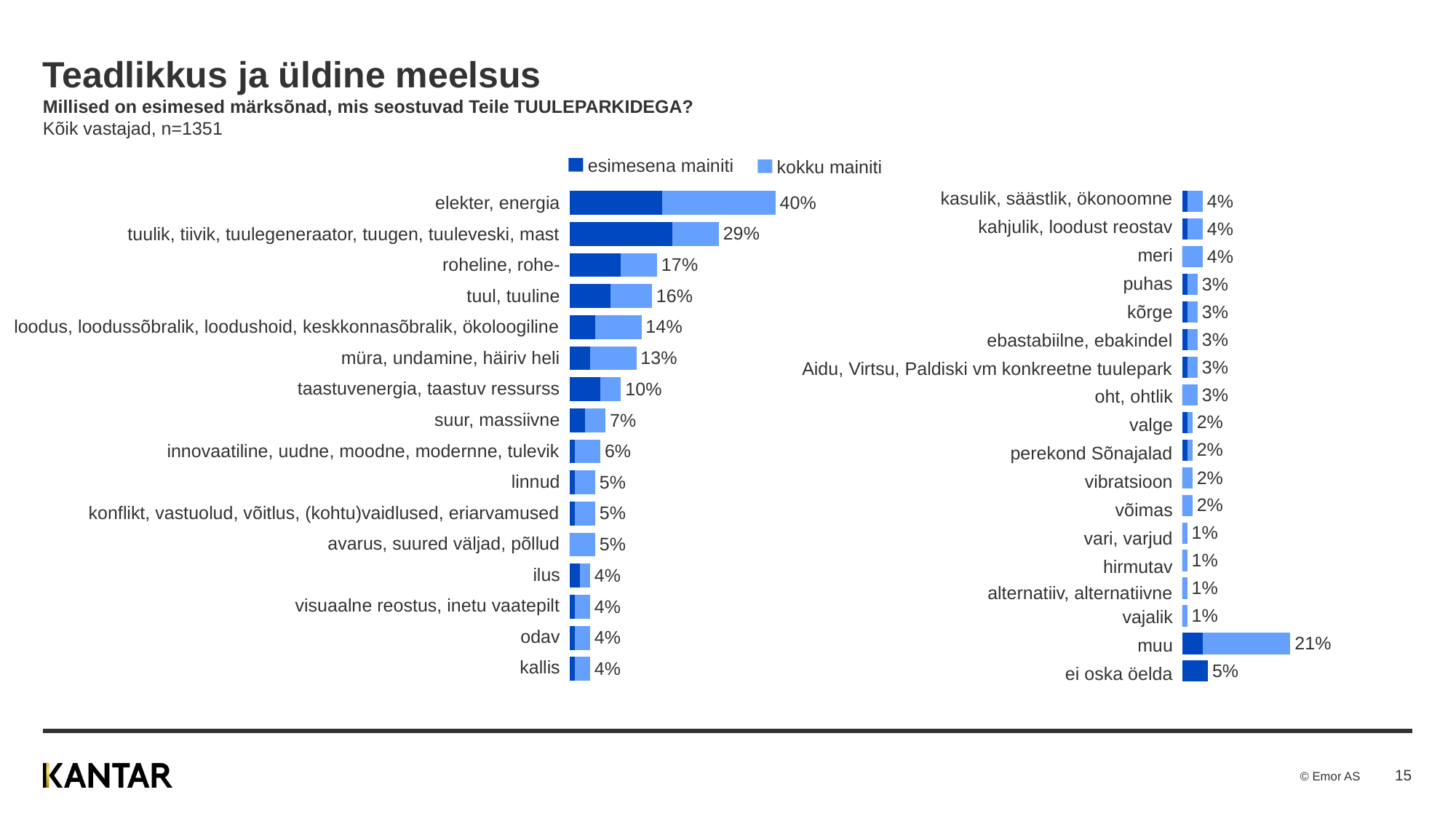
In the right chart, what is the value shown for "ei oska öelda"? 5% In the left chart, what is the value shown for "elekter, energia"? 40% In the left chart, what is the value shown for "müra, undamine, häiriv heli"? 13% In the right chart, which category has the highest value? muu How many categories are shown in the left chart? 16 In the left chart, what is the difference between the values for "elekter, energia" and "tuulik, tiivik, tuulegeneraator, tuugen, tuuleveski, mast"? 11 percentage points In the left chart, which category has the highest value? elekter, energia What kind of chart is used on this slide? bar chart In the left chart, which has the larger value: "roheline, rohe-" or "tuul, tuuline"? roheline, rohe- How many series does the legend list? 2 What are the two legend entries shown above the charts? esimesena mainiti, kokku mainiti In the right chart, what is the value shown for "muu"? 21%